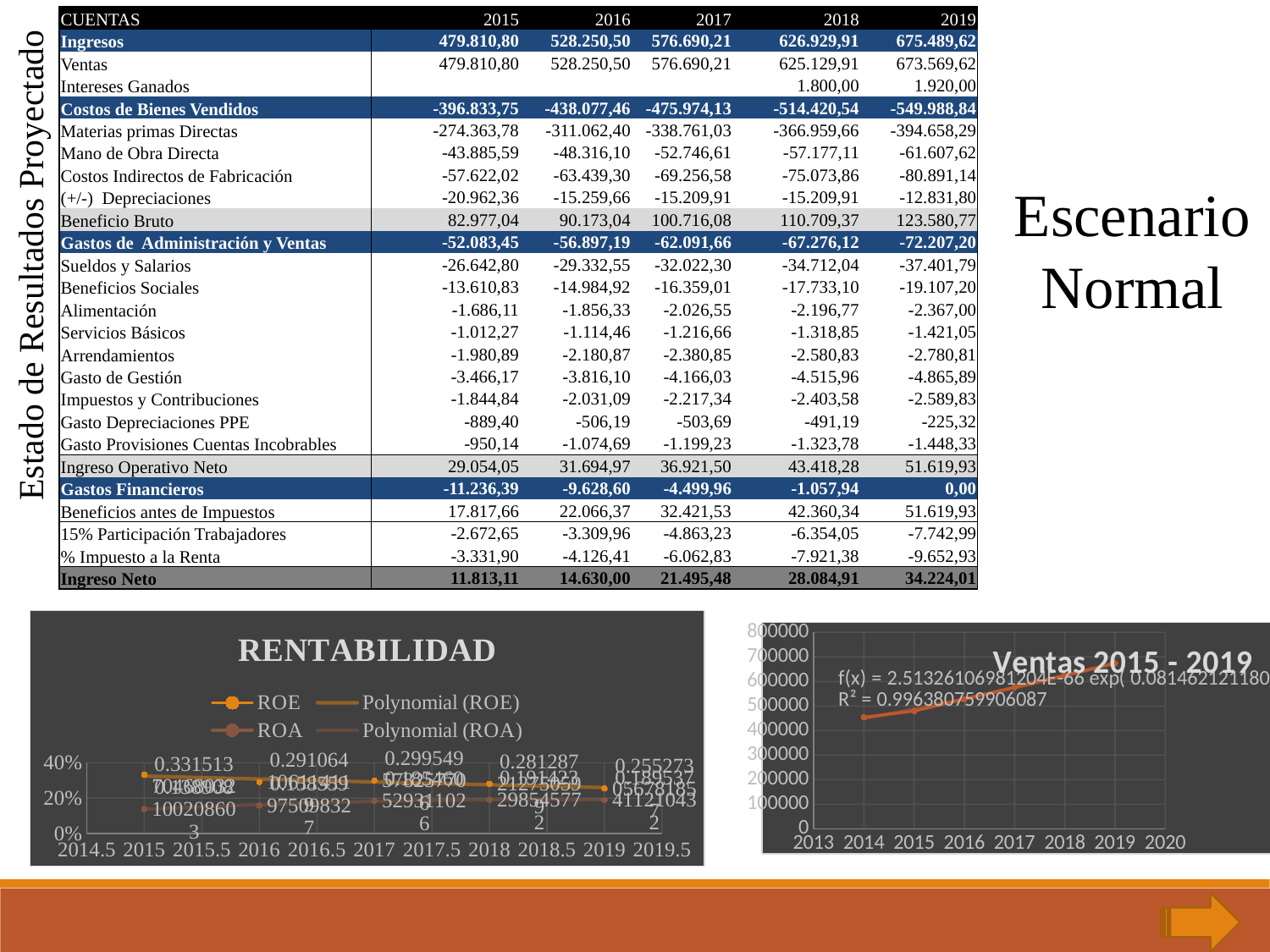
In the Ventas 2015 - 2019 chart, which year has the lowest value? 2014 What type of chart is the RENTABILIDAD chart? line chart In the Ventas 2015 - 2019 chart, is the value for 2019 greater or less than 600000? greater In the RENTABILIDAD chart, which series is higher in 2015, ROE or ROA? ROE In the RENTABILIDAD chart, is the ROE value for 2015 greater or less than 20%? greater What type of chart is the Ventas 2015 - 2019 chart? line chart In the RENTABILIDAD chart, does the ROE series generally rise or fall from 2015 to 2019? fall In the Ventas 2015 - 2019 chart, which year has the highest value? 2019 How many entries does the legend of the RENTABILIDAD chart list? 4 In the Ventas 2015 - 2019 chart, do the values rise or fall from 2015 to 2019? rise What is the title of the chart at the bottom right of the slide? Ventas 2015 - 2019 In the RENTABILIDAD chart, is the ROE value for 2019 greater or less than 40%? less